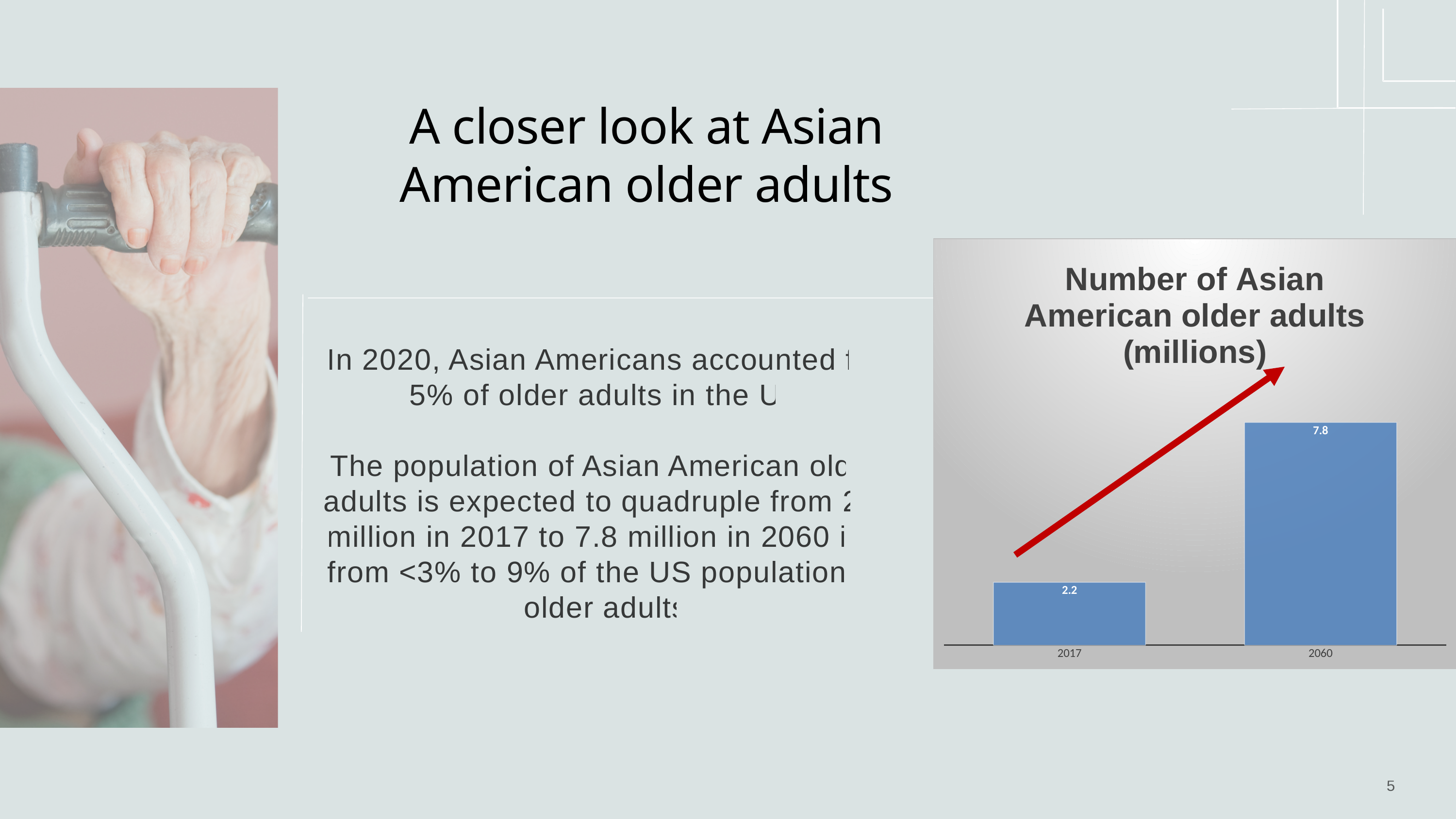
What is the difference between the values for 2060 and 2017? 5.6 Which year has the lowest value in the chart? 2017 What is the value for 2060 in the chart? 7.8 Which is larger, the value for 2017 or the value for 2060? 2060 Do the values rise or fall from 2017 to 2060? Rise What is the title of the chart? Number of Asian American older adults (millions) What kind of chart is shown on the slide? Bar chart What is the value for 2017 in the chart? 2.2 How many categories are shown on the x axis of the chart? 2 What colour are the bars in the chart? Blue Which year has the highest value in the chart? 2060